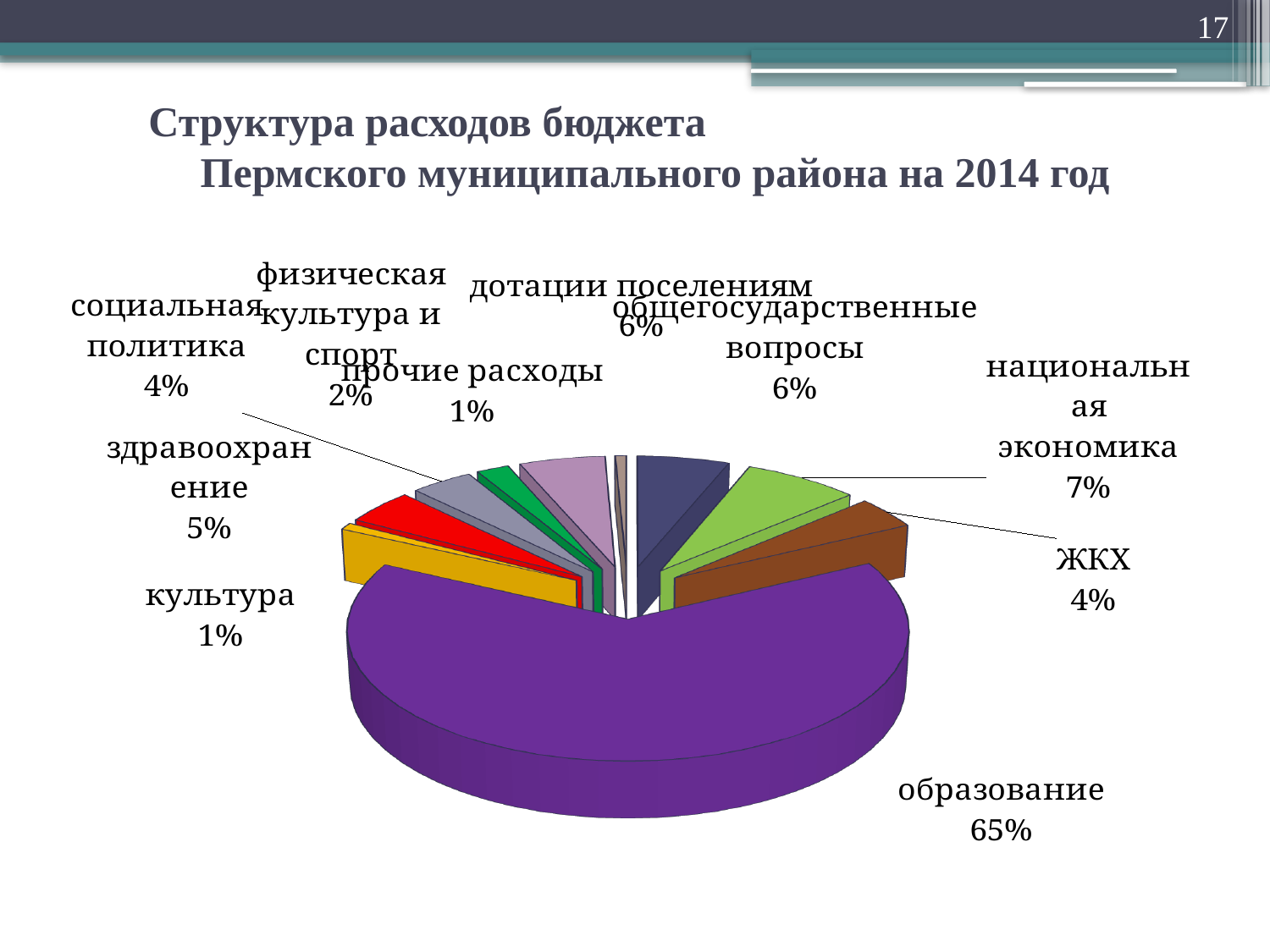
What is the difference between the shares of здравоохранение and социальная политика? 1% What is the value for физическая культура и спорт? 2% What is the value for ЖКХ? 4% Which is larger, the share of общегосударственные вопросы or the share of ЖКХ? общегосударственные вопросы What year does the chart title refer to? 2014 What share of the budget expenditure goes to образование? 65% What is the value for здравоохранение? 5% Which category has the largest share of the pie? образование What kind of chart is shown on the slide? pie chart What is the value for национальная экономика? 7% How many categories are shown in the pie chart? 10 What is the difference between the shares of образование and национальная экономика? 58%